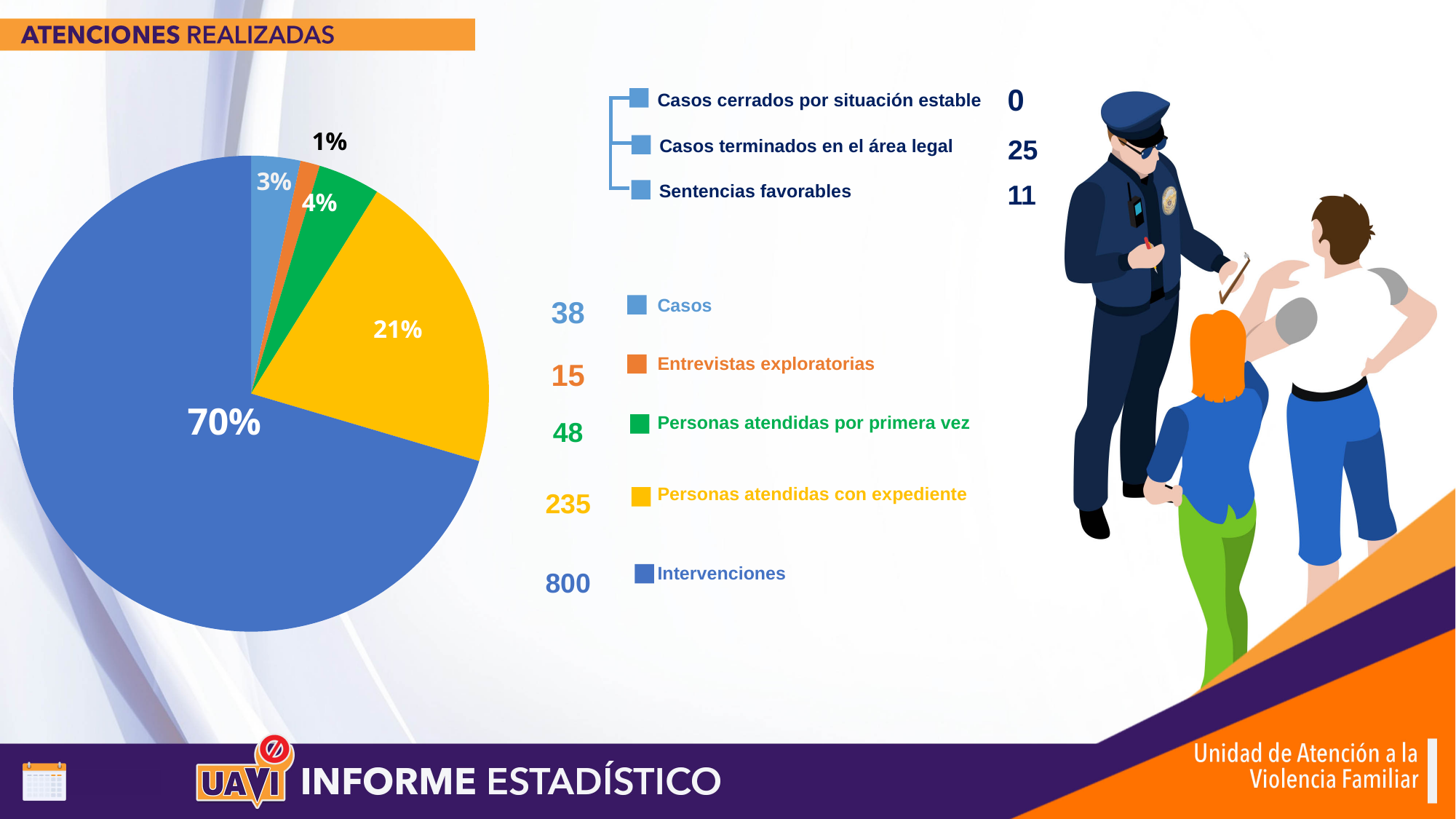
What kind of chart is shown on the slide? pie chart What is the difference in percentage points between the Intervenciones slice and the Personas atendidas con expediente slice? 49% Which category has the smallest slice of the pie? Entrevistas exploratorias Which category has the largest slice of the pie? Intervenciones What is the count shown next to Personas atendidas con expediente in the legend? 235 What percentage of the pie does Personas atendidas por primera vez represent? 4% What percentage of the pie does Casos represent? 3% What percentage of the pie does Entrevistas exploratorias represent? 1% How many slices does the pie chart have? 5 Which is larger, the share for Casos or the share for Personas atendidas por primera vez? Personas atendidas por primera vez